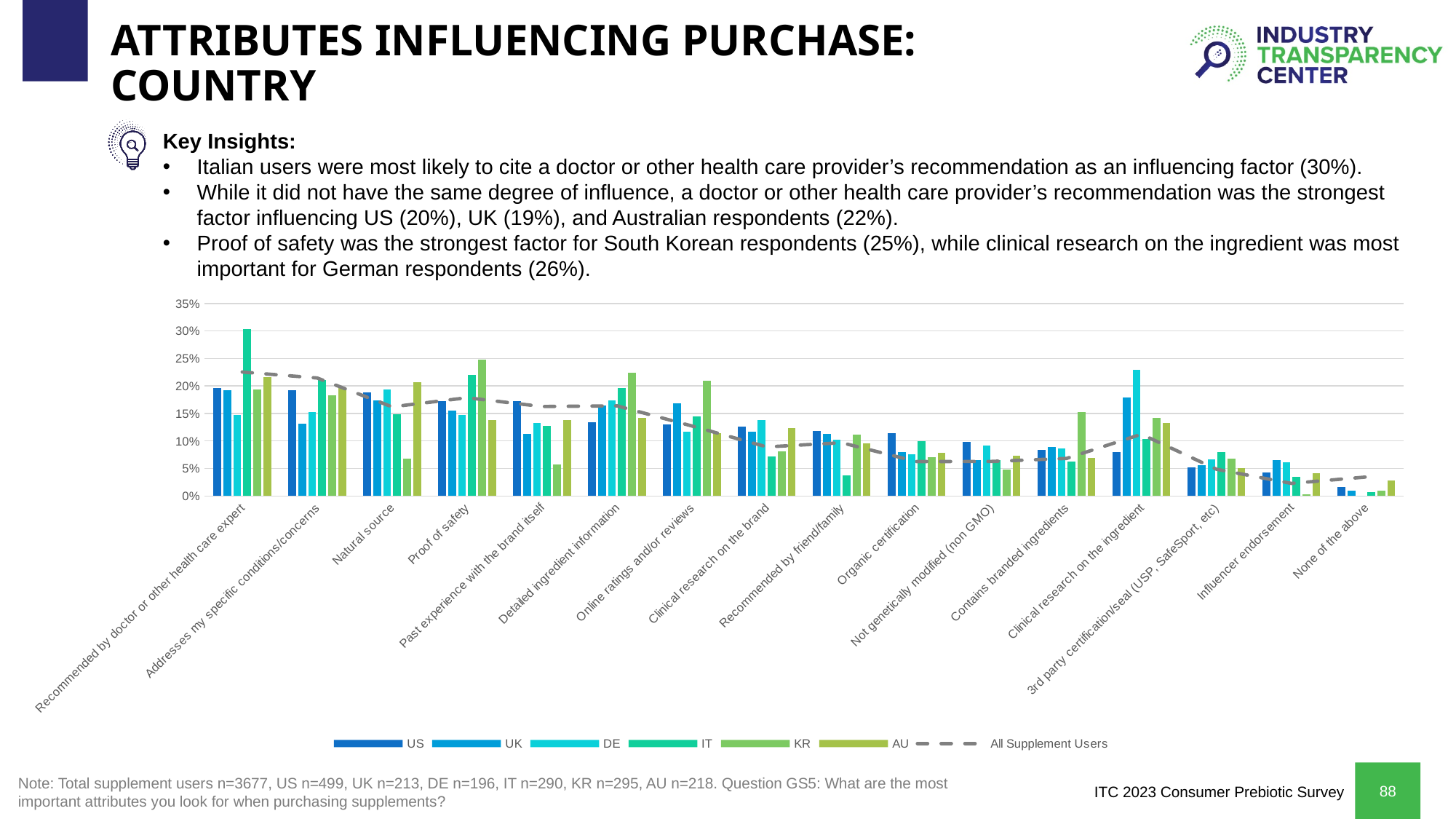
According to the slide, what percentage of Italian users cited a doctor or other health care provider's recommendation as an influencing factor? 30% According to the slide, what percentage of German respondents cited clinical research on the ingredient? 26% How is the 'All Supplement Users' series drawn in the chart? as a dashed grey line Which country has the highest bar for 'Recommended by doctor or other health care expert'? IT How many series does the chart legend list? 7 What kind of chart is shown on the slide? combination bar and line chart For 'Proof of safety', which is larger: the KR value or the US value? KR Is the DE value for 'Clinical research on the ingredient' greater or less than 20%? greater Is the US value for 'None of the above' greater or less than 5%? less Does the dashed 'All Supplement Users' line generally rise or fall from left to right across the categories? fall How many attribute categories are shown along the x axis of the chart? 16 Is the IT value for 'Recommended by doctor or other health care expert' greater or less than 25%? greater